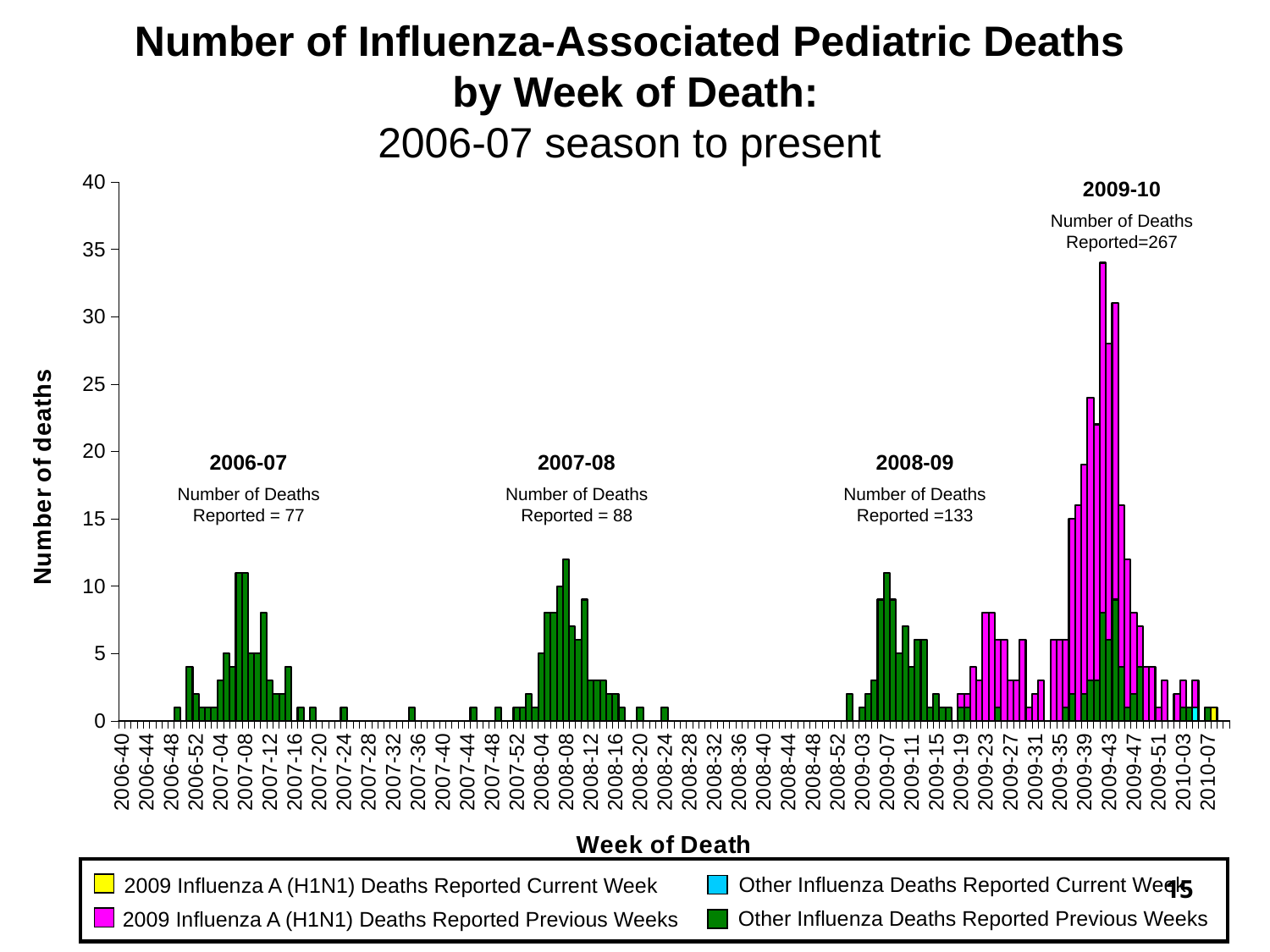
How many deaths were reported in the 2009-10 season according to the chart annotation? 267 What is the label of the y-axis? Number of deaths Which season has the highest number of deaths reported? 2009-10 How many series does the legend list? 4 How many deaths were reported in the 2006-07 season according to the chart annotation? 77 What is the difference between the number of deaths reported in the 2009-10 season and the 2008-09 season? 134 Which season has the lowest number of deaths reported? 2006-07 Is the value of the tallest bar in the 2009-10 season greater or less than 30? greater Which season had more deaths reported, 2007-08 or 2008-09? 2008-09 What type of chart is shown on the slide? bar chart How many deaths were reported in the 2008-09 season according to the chart annotation? 133 How many deaths were reported in the 2007-08 season according to the chart annotation? 88